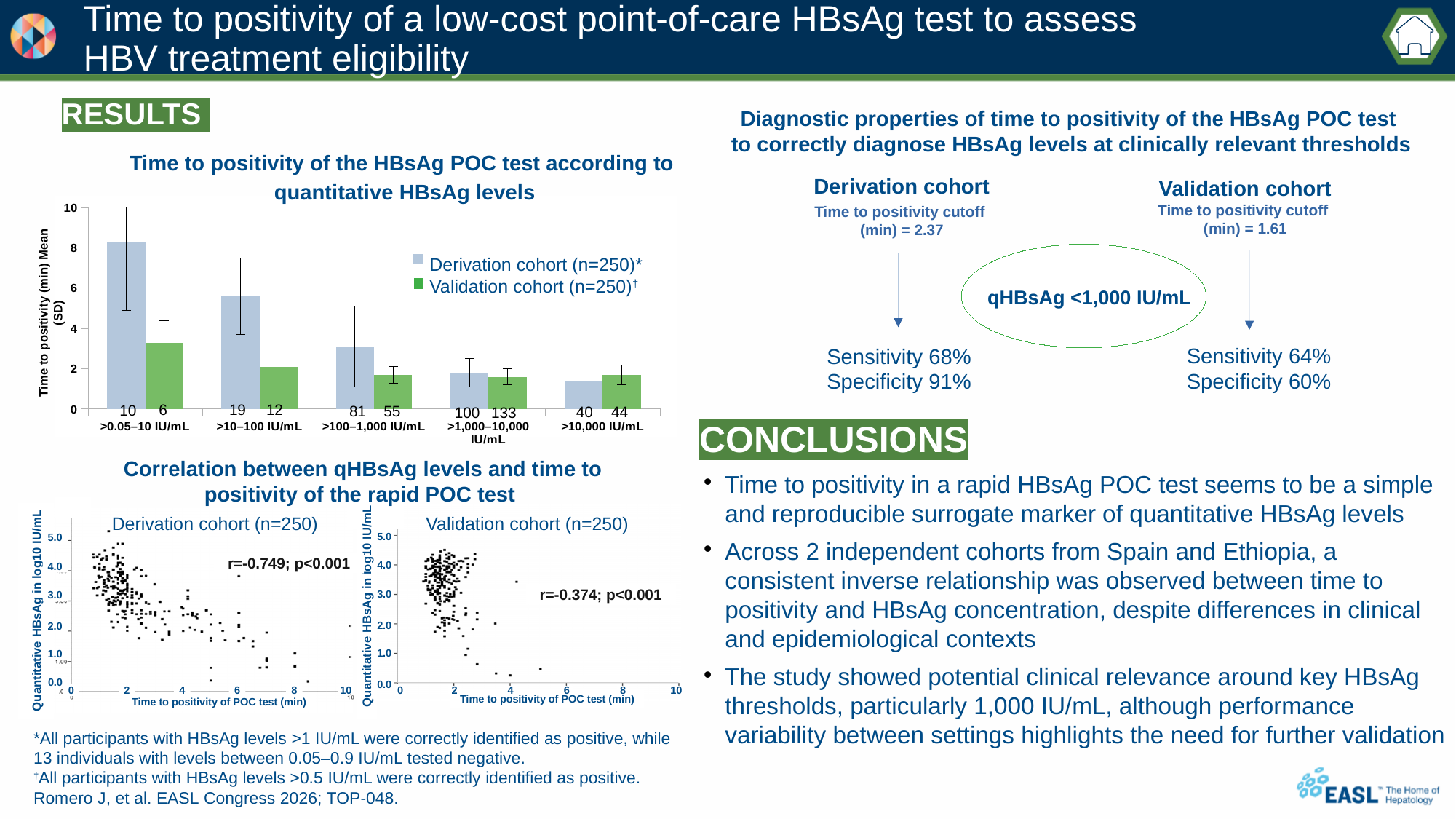
In the 'Correlation between qHBsAg levels and time to positivity of the rapid POC test' charts, what correlation coefficient is shown for the Derivation cohort? r=-0.749; p<0.001 In the chart 'Time to positivity of the HBsAg POC test according to quantitative HBsAg levels', is the Derivation cohort value for >100–1,000 IU/mL greater or less than 2? greater In the chart 'Time to positivity of the HBsAg POC test according to quantitative HBsAg levels', which HBsAg level category has the lowest mean time to positivity for the Derivation cohort? >10,000 IU/mL In the chart 'Time to positivity of the HBsAg POC test according to quantitative HBsAg levels', which HBsAg level category has the highest mean time to positivity for the Derivation cohort? >0.05–10 IU/mL In the chart 'Time to positivity of the HBsAg POC test according to quantitative HBsAg levels', is the Derivation cohort value for >0.05–10 IU/mL greater or less than 6? greater In the chart 'Time to positivity of the HBsAg POC test according to quantitative HBsAg levels', what kind of chart is used? Bar chart In the chart 'Time to positivity of the HBsAg POC test according to quantitative HBsAg levels', do the Derivation cohort values rise or fall as the HBsAg level increases along the x axis? fall In the chart 'Time to positivity of the HBsAg POC test according to quantitative HBsAg levels', for the >10–100 IU/mL category, which cohort has the larger mean time to positivity? Derivation cohort In the chart 'Time to positivity of the HBsAg POC test according to quantitative HBsAg levels', how many series does the legend list? 2 In the 'Correlation between qHBsAg levels and time to positivity of the rapid POC test' charts, what correlation coefficient is shown for the Validation cohort? r=-0.374; p<0.001 In the chart 'Time to positivity of the HBsAg POC test according to quantitative HBsAg levels', is the Validation cohort value for >0.05–10 IU/mL greater or less than 4? less In the chart 'Time to positivity of the HBsAg POC test according to quantitative HBsAg levels', how many HBsAg level categories are shown on the x axis? 5